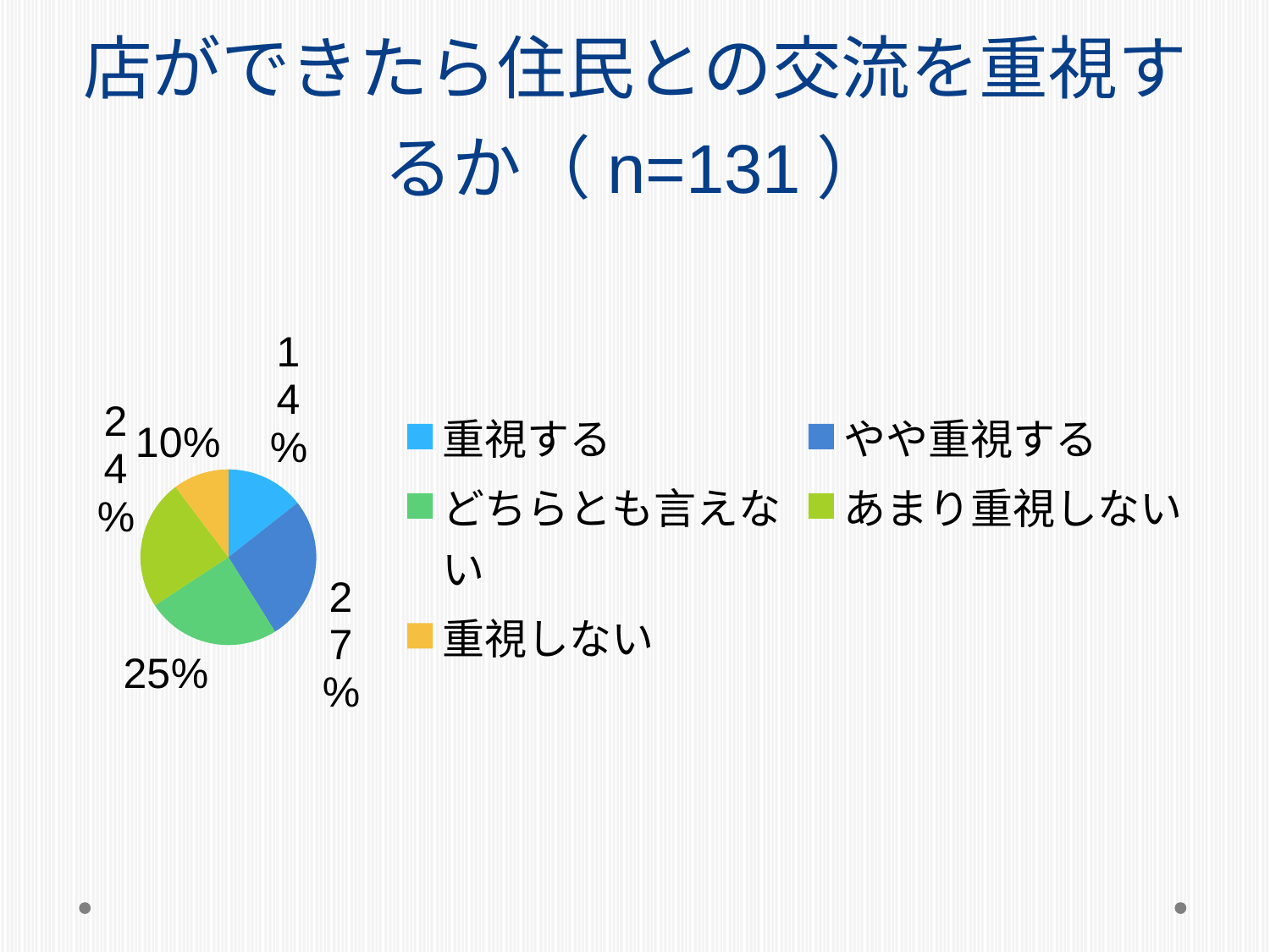
Which response has the smallest share of the pie? 重視しない What percentage of respondents answered どちらとも言えない? 25% What kind of chart is shown on the slide? pie chart What percentage of respondents answered 重視する? 14% What percentage of respondents answered やや重視する? 27% Which is larger, the share for 重視する or the share for 重視しない? 重視する Which response has the largest share of the pie? やや重視する What is the difference in percentage points between やや重視する and 重視する? 13 How many categories does the pie chart have? 5 What percentage of respondents answered 重視しない? 10% What is the sample size (n) given in the chart title? 131 What percentage of respondents answered あまり重視しない? 24%